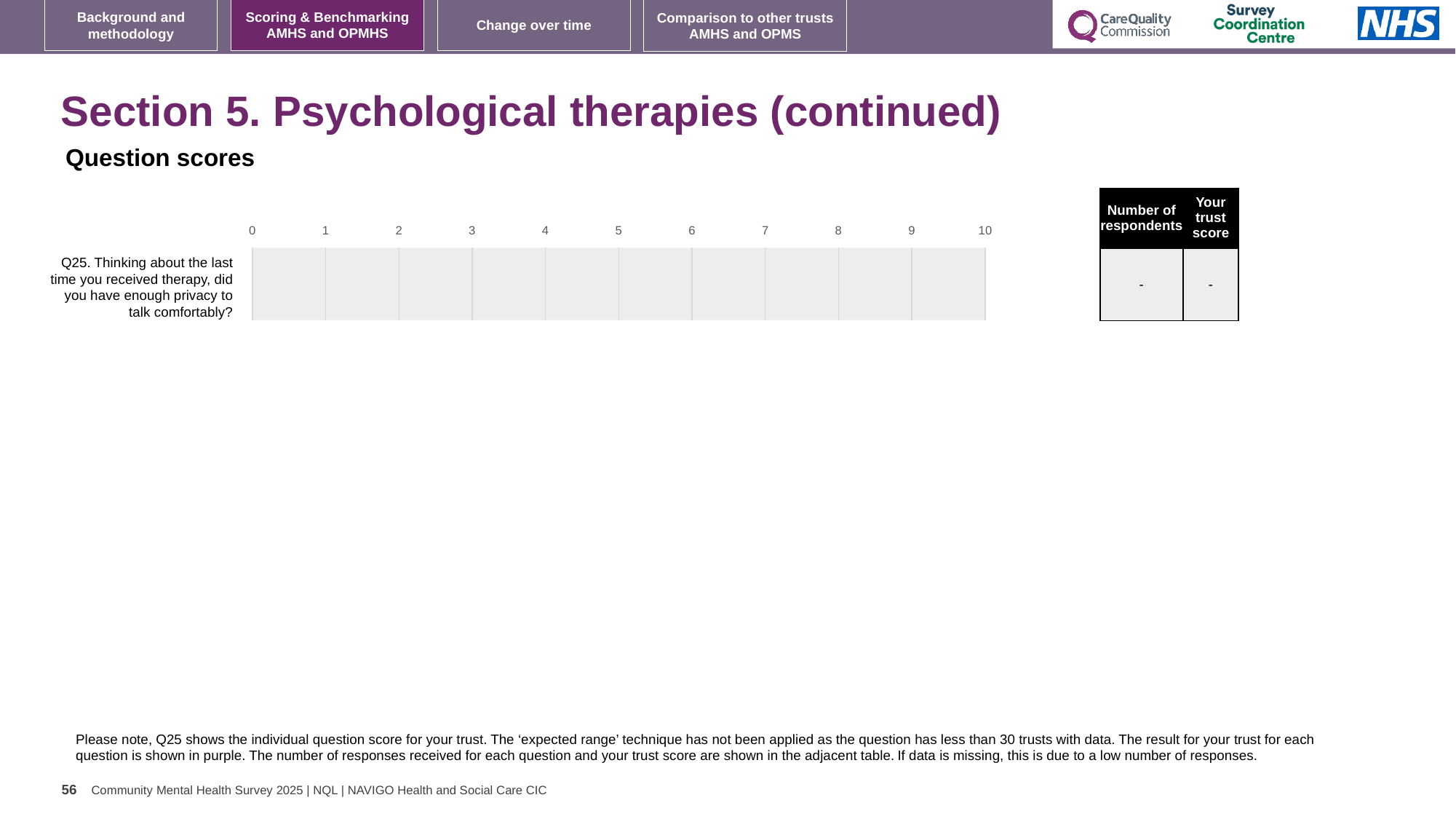
What is the highest value shown on the chart's x axis? 10 What is the lowest value shown on the chart's x axis? 0 How many questions (categories) are plotted on the chart? 1 Which question number is the single category on the chart? Q25 What is the 'Your trust score' value shown in the table for Q25? - What is the 'Number of respondents' value shown in the table for Q25? -